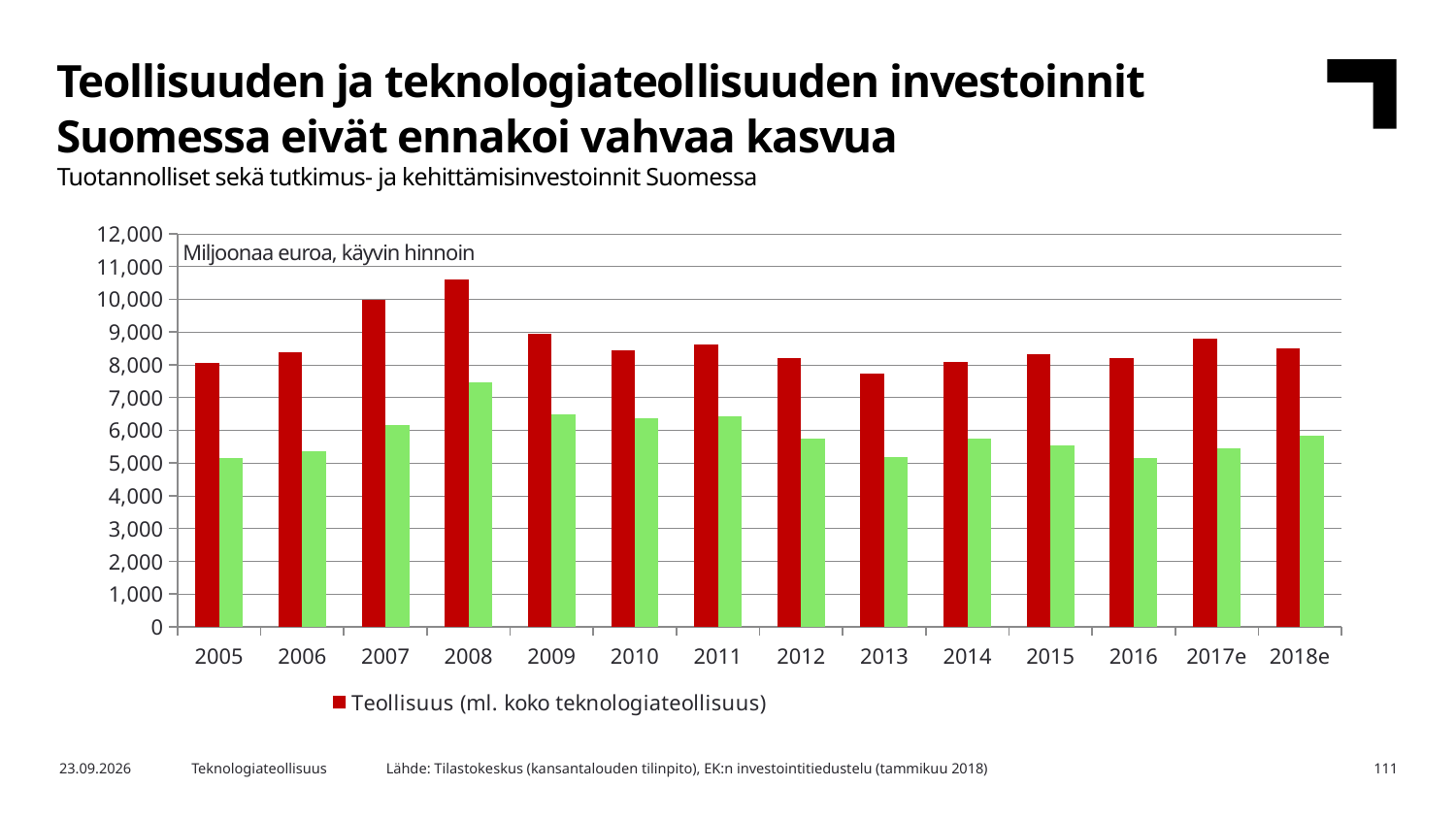
In which year is the green bar the highest? 2008 In which year is the red bar (Teollisuus) the lowest? 2013 Is the value of the green bar for 2005 greater or less than 6,000? less Which year has the larger green bar, 2009 or 2012? 2009 How many series does the chart's legend list? 1 What unit is stated in the label inside the chart's plot area? Miljoonaa euroa, käyvin hinnoin Do the red bars (Teollisuus) rise or fall from 2005 to 2008? rise Is the value of the red bar (Teollisuus) for 2008 greater or less than 10,000? greater In which year is the red bar (Teollisuus) the highest? 2008 What kind of chart is shown on the slide? Bar chart How many years (categories) are shown on the x axis of the chart? 14 Is the value of the red bar (Teollisuus) for 2013 greater or less than 8,000? less